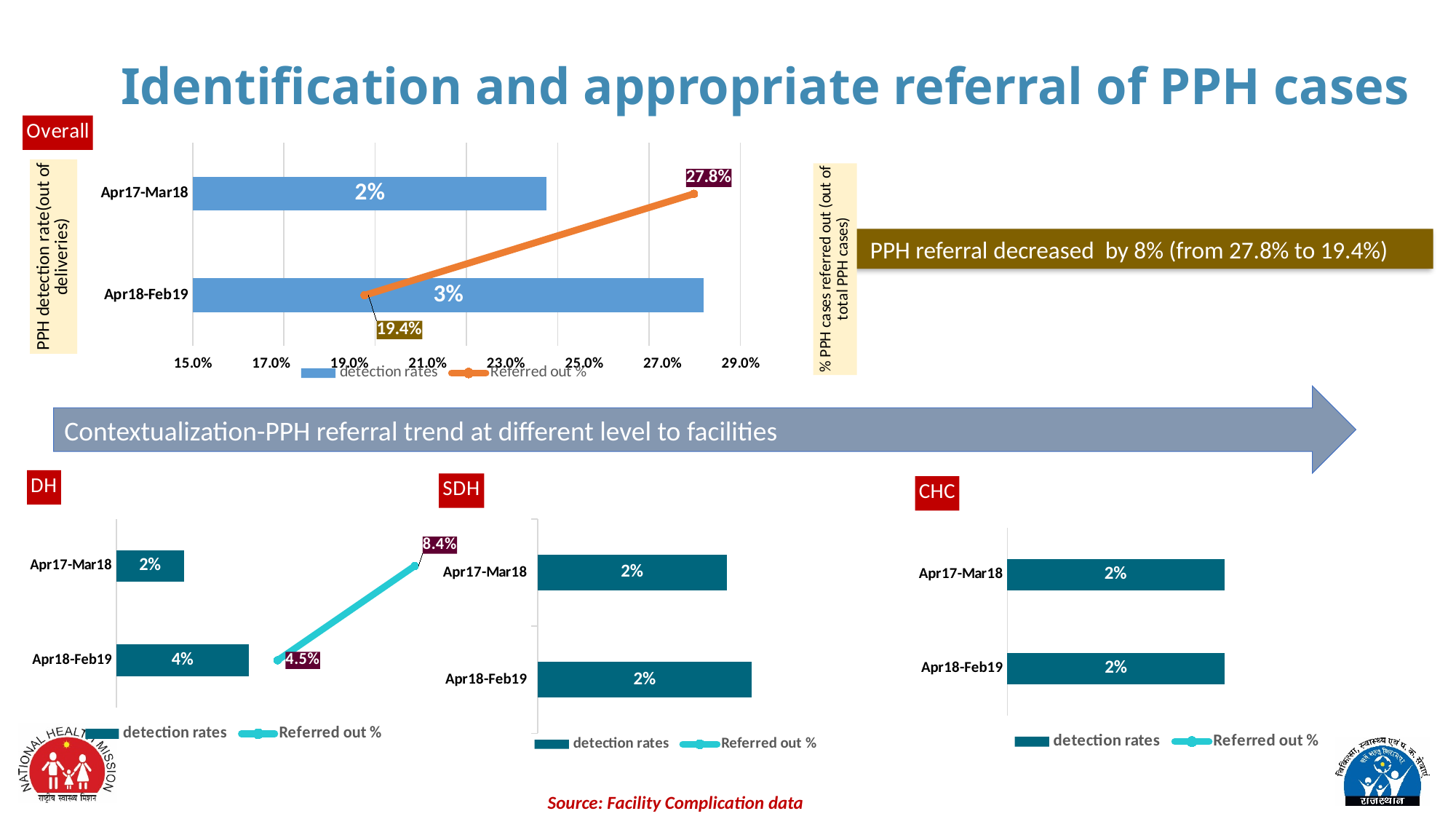
In the Overall chart, what is the Referred out % for Apr17-Mar18? 27.8% In the DH chart, what is the Referred out % for Apr17-Mar18? 8.4% How many periods are shown in the SDH chart? 2 In the DH chart, what is the difference between the Referred out % for Apr17-Mar18 and Apr18-Feb19? 3.9% In the DH chart, what is the Referred out % for Apr18-Feb19? 4.5% In the DH chart, what is the difference between the detection rates for Apr18-Feb19 and Apr17-Mar18? 2% In the Overall chart, what is the detection rate for Apr18-Feb19? 3% How many series does the legend of the SDH chart list? 2 In the DH chart, what is the detection rate for Apr18-Feb19? 4% In the Overall chart, what is the Referred out % for Apr18-Feb19? 19.4% In the Overall chart, which period has the higher Referred out %? Apr17-Mar18 In the CHC chart, what is the detection rate for Apr17-Mar18? 2%